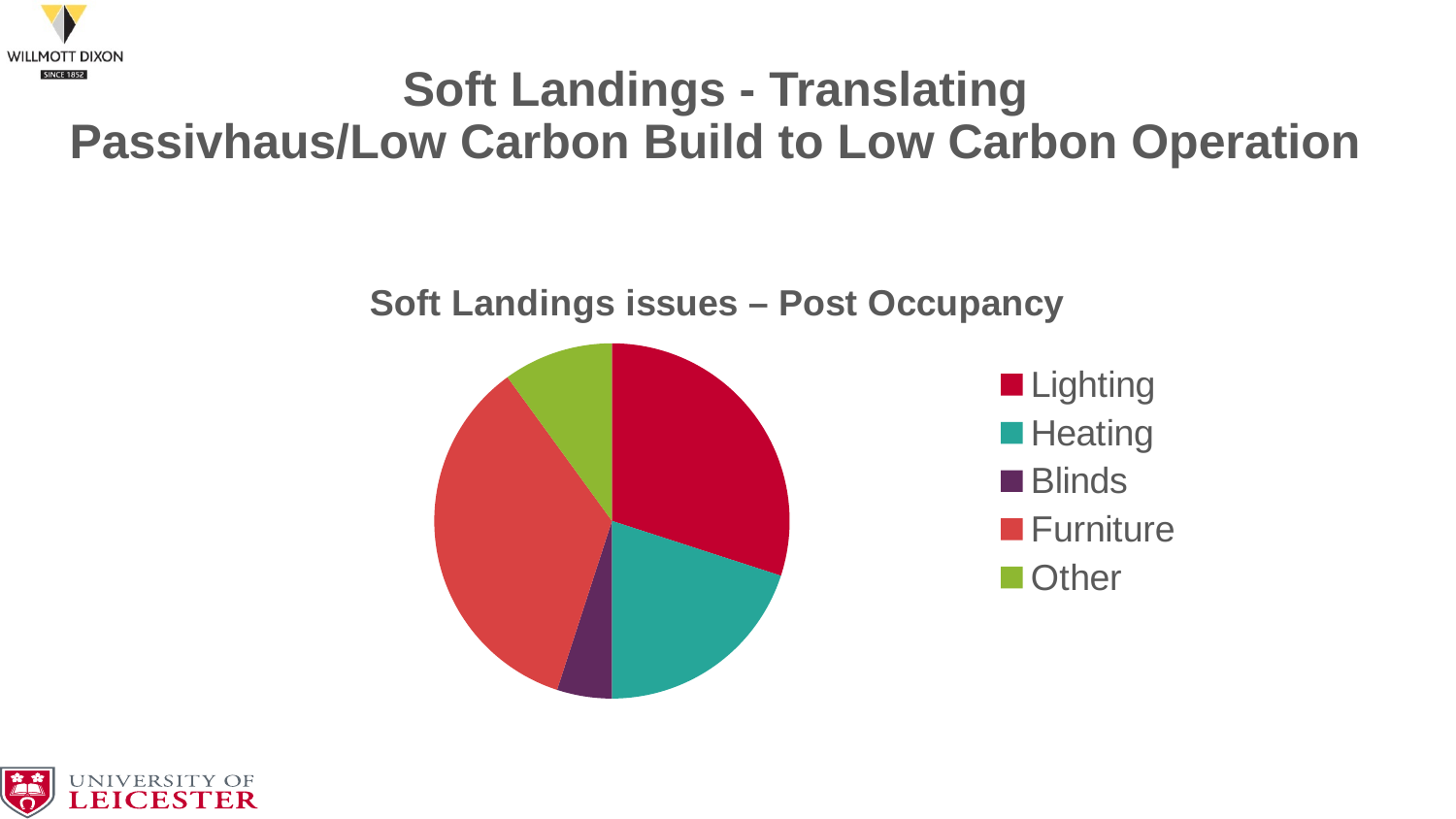
Which slice is larger, Lighting or Heating? Lighting Which category has the largest slice of the pie? Furniture How many entries does the legend list? 5 What is the title of the chart? Soft Landings issues – Post Occupancy What kind of chart is shown on the slide? pie chart Which slice is larger, Heating or Other? Heating Which slice is larger, Blinds or Other? Other Which category is shown in green in the pie chart? Other Which category has the smallest slice of the pie? Blinds How many categories does the pie chart show? 5